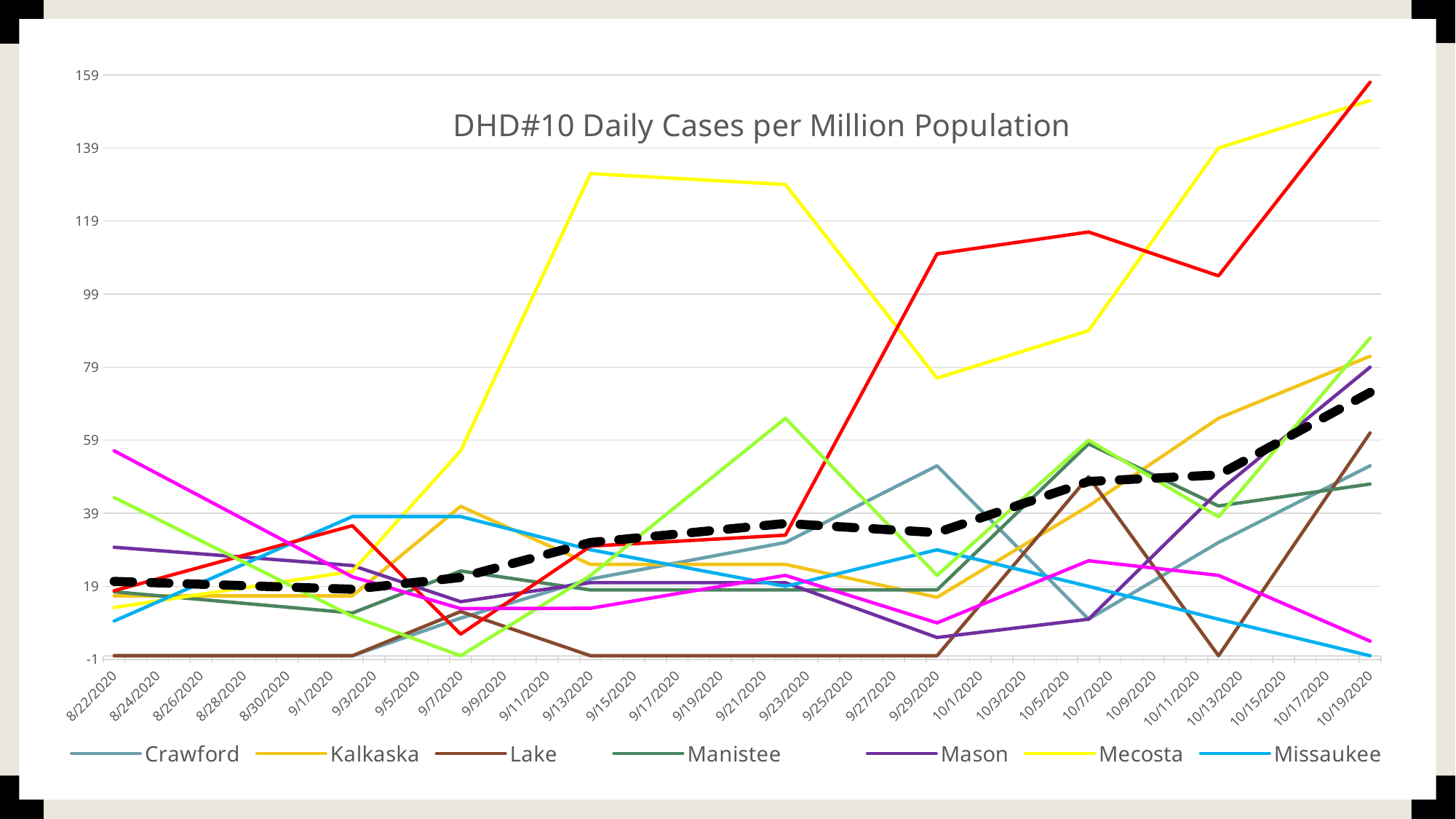
Which series has the highest value on 10/13/2020? Mecosta Does the Mecosta line rise or fall from 10/7/2020 to 10/19/2020? rise Is the value for Mecosta on 10/7/2020 greater or less than 99? less What is the title of the chart? DHD#10 Daily Cases per Million Population Which is larger on 10/7/2020, the value for Crawford or the value for Lake? Lake How many dates are labelled along the x axis? 30 Is the value for Missaukee on 10/19/2020 greater or less than 19? less Is the value for Mecosta on 9/13/2020 greater or less than 119? greater Which is larger on 10/19/2020, the value for Mecosta or the value for Missaukee? Mecosta How many series does the chart's legend list? 7 What kind of chart is shown on the slide? line chart Which series has the highest value on 9/13/2020? Mecosta